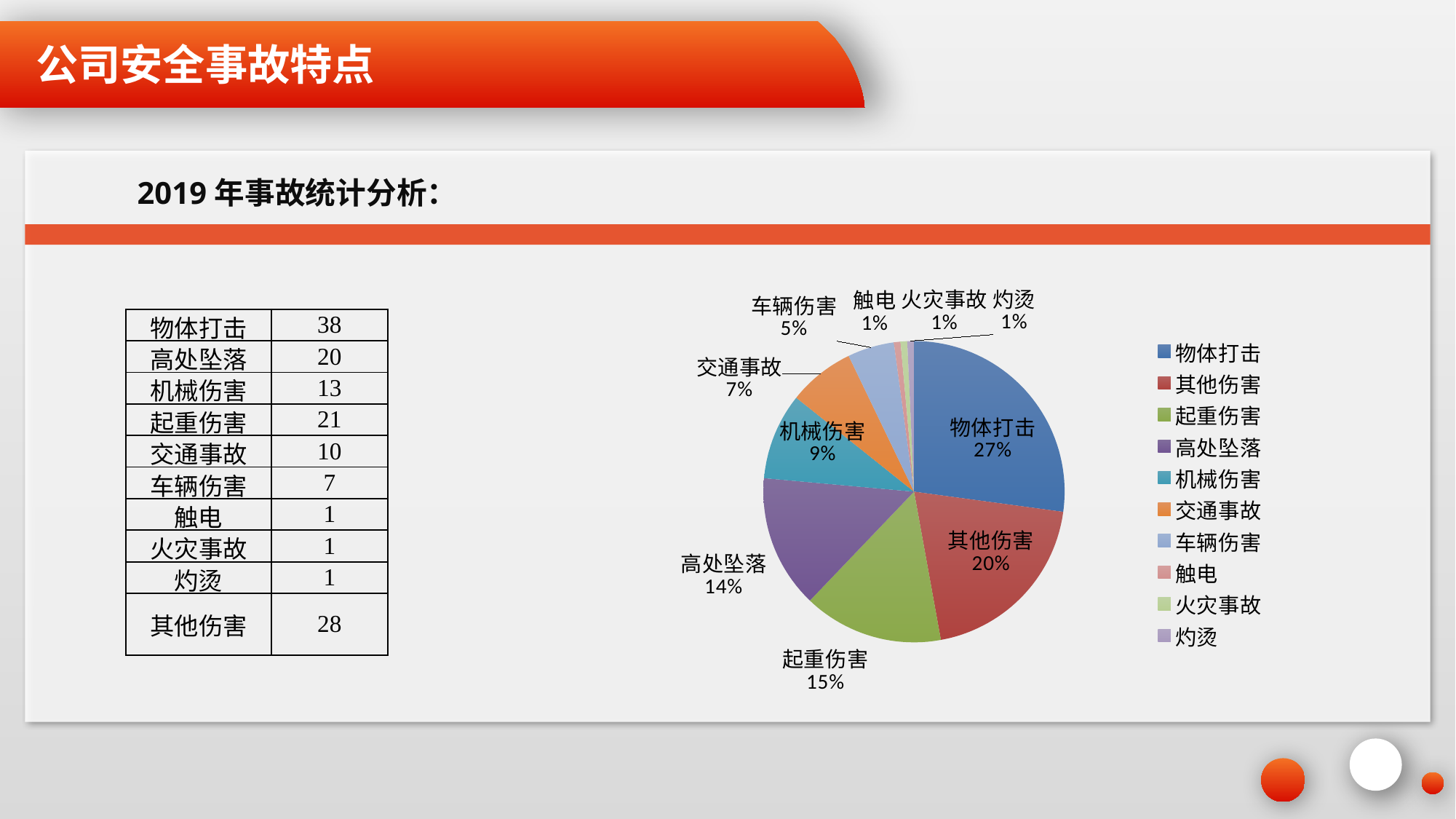
What percentage is shown for 起重伤害 in the pie chart? 15% What percentage is shown for 机械伤害 in the pie chart? 9% Which slice is larger in the pie chart, 交通事故 or 车辆伤害? 交通事故 How many categories does the legend of the pie chart list? 10 What type of chart is shown on the slide? pie chart What percentage is shown for 高处坠落 in the pie chart? 14% Which category has the largest slice in the pie chart? 物体打击 What share of the pie does 物体打击 account for? 27% What is the difference in percentage points between 物体打击 and 其他伤害 in the pie chart? 7 What colour is the 物体打击 slice in the pie chart? blue What share of the pie does 其他伤害 account for? 20% What percentage is shown for 触电 in the pie chart? 1%